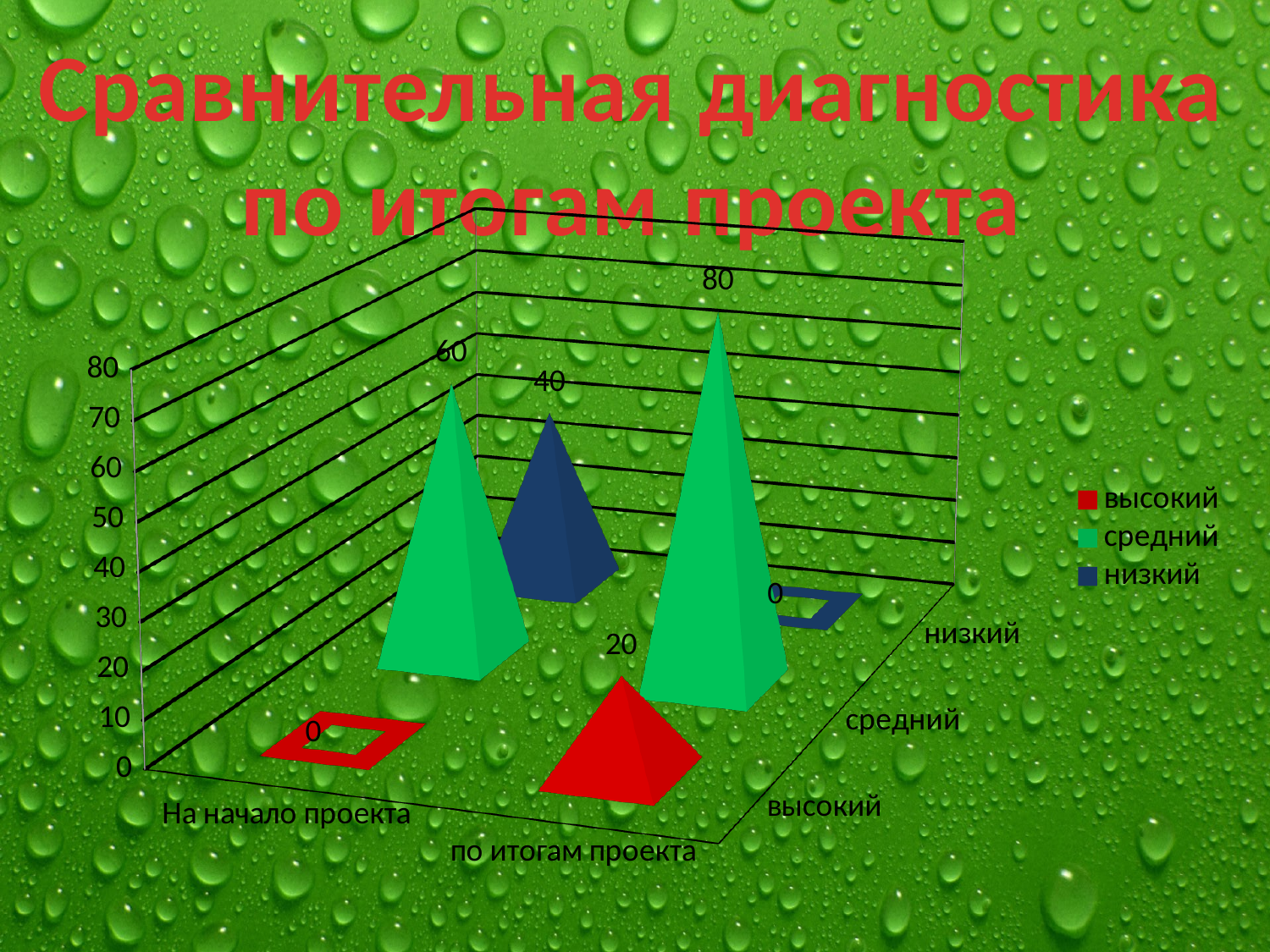
Which series has the lowest value at На начало проекта? высокий How many series does the legend list? 3 What is the value for средний at по итогам проекта? 80 What is the value for средний at На начало проекта? 60 What is the difference between the средний values at по итогам проекта and На начало проекта? 20 What is the value for высокий at На начало проекта? 0 What is the title of the slide? Сравнительная диагностика по итогам проекта What is the value for высокий at по итогам проекта? 20 Which is larger: низкий at На начало проекта or низкий at по итогам проекта? низкий at На начало проекта How many categories are shown on the x axis? 2 What is the value for низкий at На начало проекта? 40 Which series has the highest value at по итогам проекта? средний